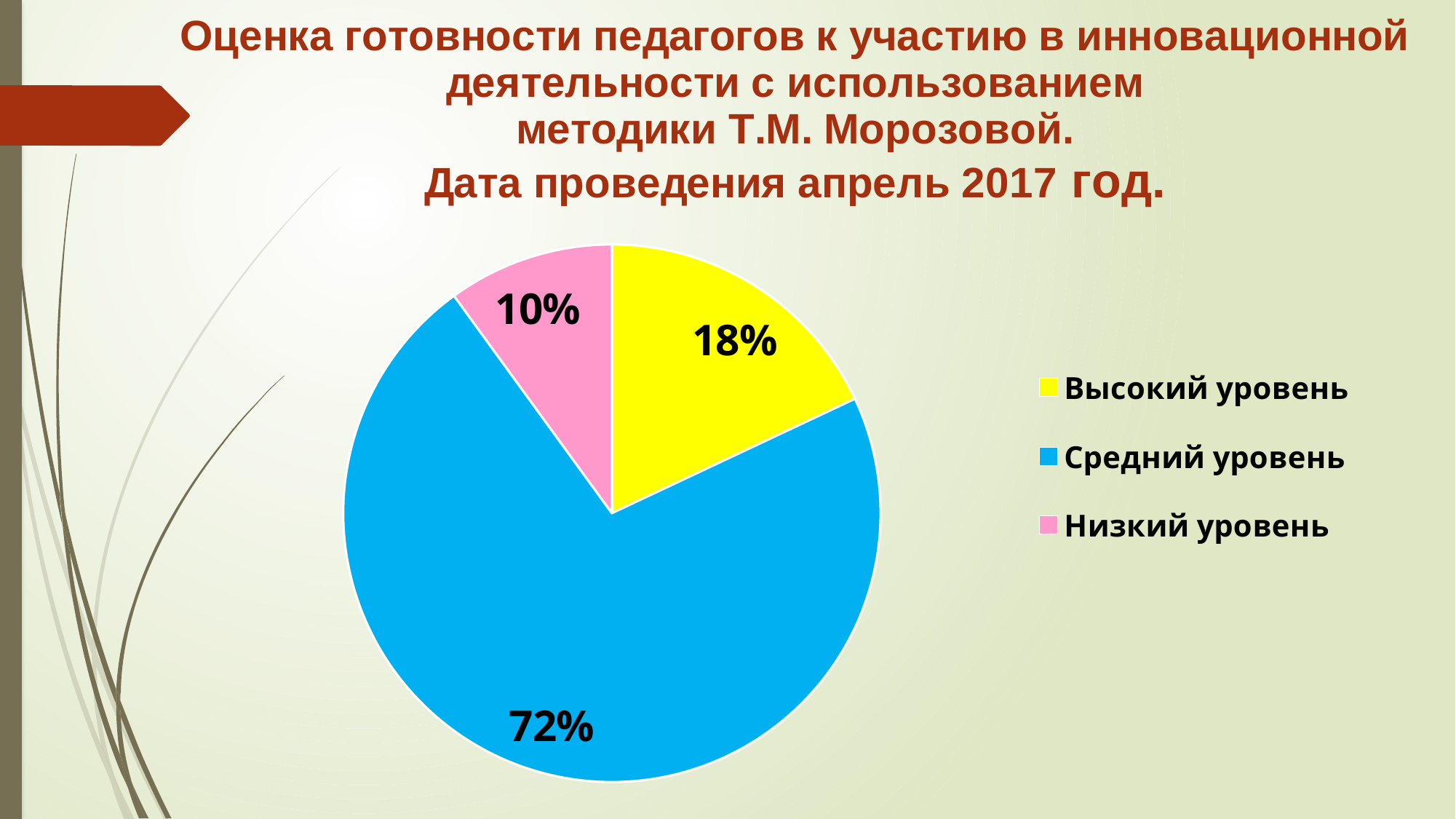
How many slices does the pie chart have? 3 Which category has the smallest slice of the pie? Низкий уровень What share of the pie does "Средний уровень" take? 72% What colour is the slice for "Средний уровень"? blue What is the difference in percentage points between "Средний уровень" and "Высокий уровень"? 54 What kind of chart is shown on the slide? pie chart What share of the pie does "Низкий уровень" take? 10% What share of the pie does "Высокий уровень" take? 18% Which category has the largest slice of the pie? Средний уровень Which is larger, the slice for "Высокий уровень" or the slice for "Низкий уровень"? Высокий уровень What is the difference in percentage points between "Высокий уровень" and "Низкий уровень"? 8 How many entries does the legend list? 3